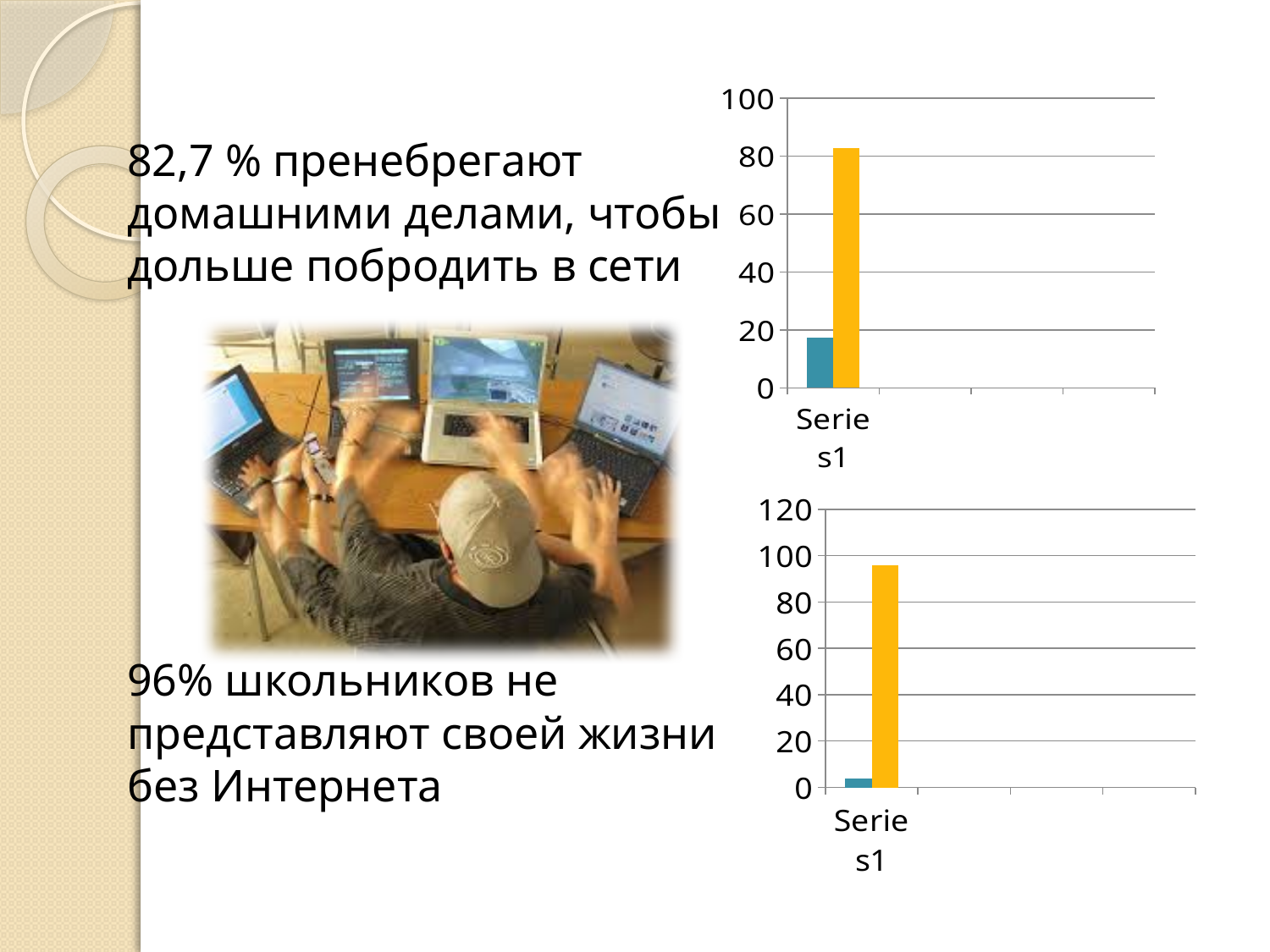
How many bars are plotted in the bottom chart? 2 What category label appears under the bars in the top chart? Series1 In the bottom chart, is the value of the orange bar greater or less than 80? greater In the top chart, which bar is taller, the blue bar or the orange bar? the orange bar What is the highest value shown on the y axis of the bottom chart? 120 In the bottom chart, which bar is shorter, the blue bar or the orange bar? the blue bar What kind of chart is the bottom chart on the slide? bar chart How many bars are plotted in the top chart? 2 In the bottom chart, is the value of the blue bar greater or less than 20? less In the top chart, is the value of the blue bar greater or less than 20? less What kind of chart is the top chart on the slide? bar chart